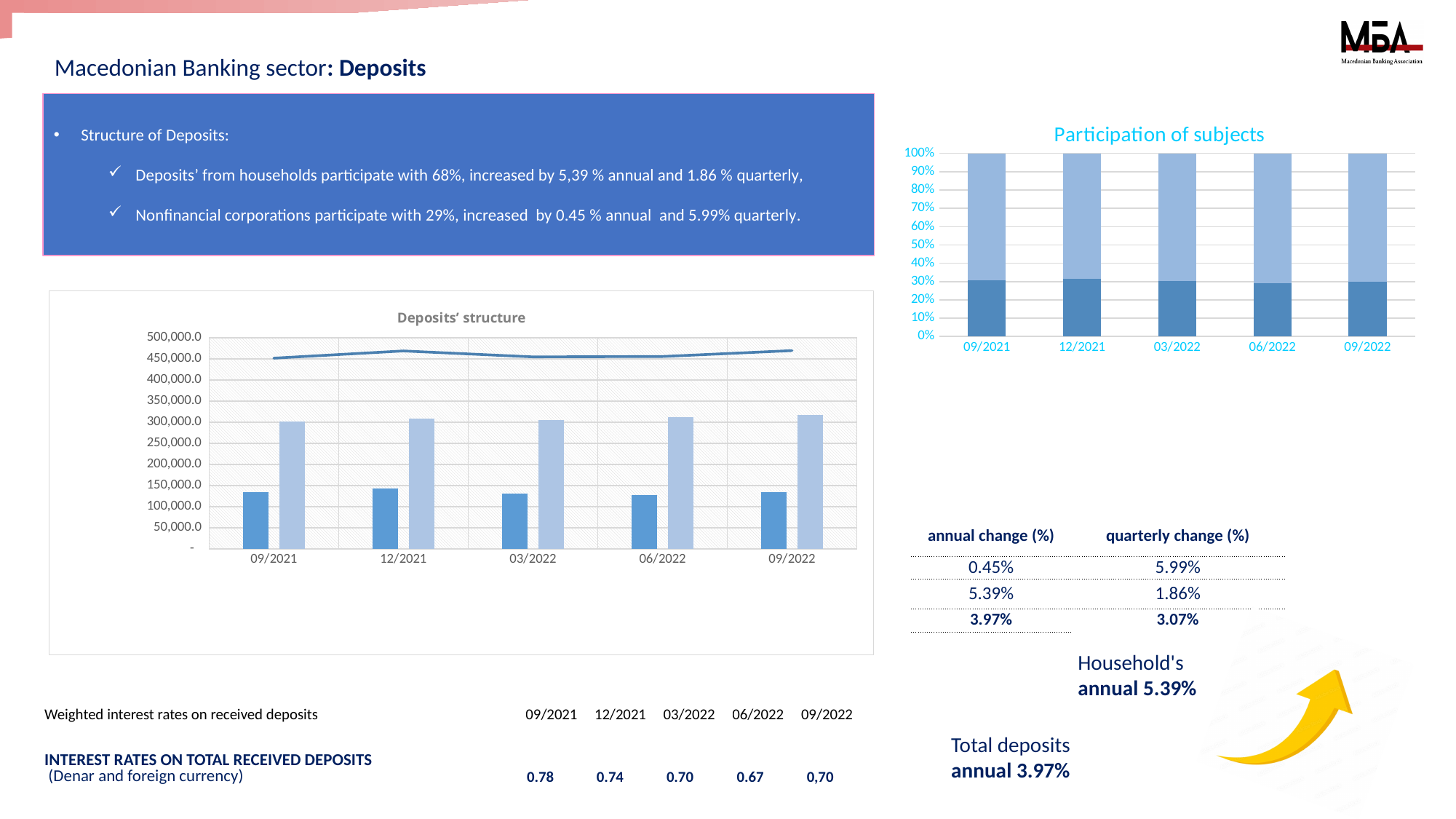
In the 'Deposits' structure' chart, is the line value for 12/2021 greater or less than 400,000.0? greater In the 'Participation of subjects' chart, how many periods are shown on the x axis? 5 In the 'Deposits' structure' chart, is the value of the dark blue bar for 06/2022 greater or less than 150,000.0? less In the 'Deposits' structure' chart, which is larger for 03/2022, the dark blue bar or the light blue bar? the light blue bar What kind of chart is the 'Deposits' structure' chart? Bar chart with a line In the 'Participation of subjects' chart, what is the top value shown on the y axis? 100% In the 'Deposits' structure' chart, how many time periods are shown on the x axis? 5 In the 'Participation of subjects' chart, is the dark blue segment for 09/2021 greater or less than 50%? less What is the title of the chart on the right side of the slide? Participation of subjects In the 'Deposits' structure' chart, which period has the tallest light blue bar? 09/2022 What kind of chart is the 'Participation of subjects' chart? Stacked bar chart